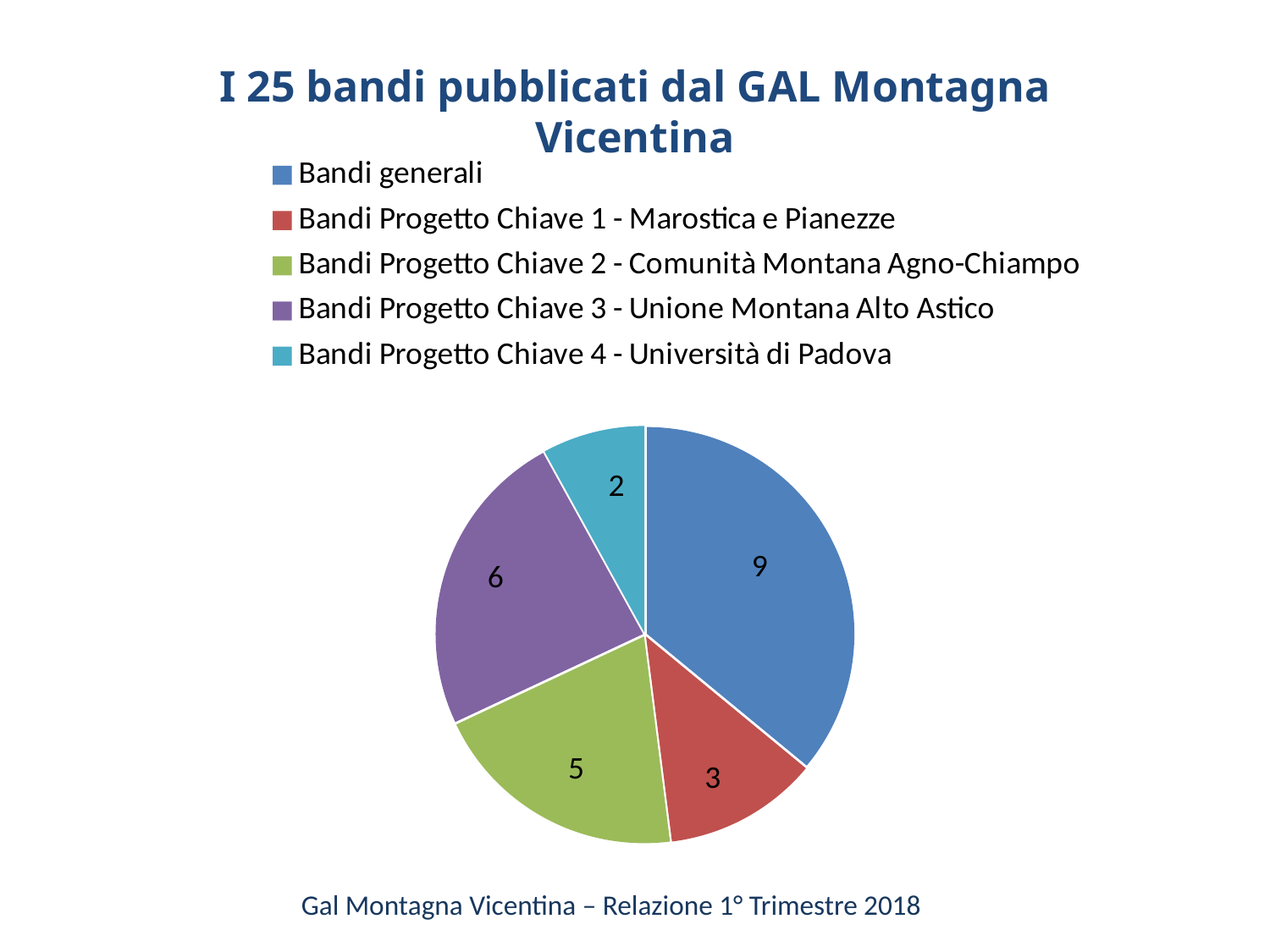
How many slices does the pie chart have? 5 What is the value for Bandi Progetto Chiave 4 - Università di Padova? 2 What share of the pie does Bandi generali represent? 36% Which category has the largest slice of the pie? Bandi generali What is the value for Bandi Progetto Chiave 3 - Unione Montana Alto Astico? 6 What kind of chart is shown on the slide? Pie chart Which is larger: Bandi Progetto Chiave 2 - Comunità Montana Agno-Chiampo or Bandi Progetto Chiave 3 - Unione Montana Alto Astico? Bandi Progetto Chiave 3 - Unione Montana Alto Astico How many bandi are shown for Bandi generali? 9 Which category has the smallest slice of the pie? Bandi Progetto Chiave 4 - Università di Padova What is the total of all the slices in the pie chart? 25 What is the difference between the value for Bandi generali and the value for Bandi Progetto Chiave 1 - Marostica e Pianezze? 6 What colour is the slice for Bandi Progetto Chiave 1 - Marostica e Pianezze? Red